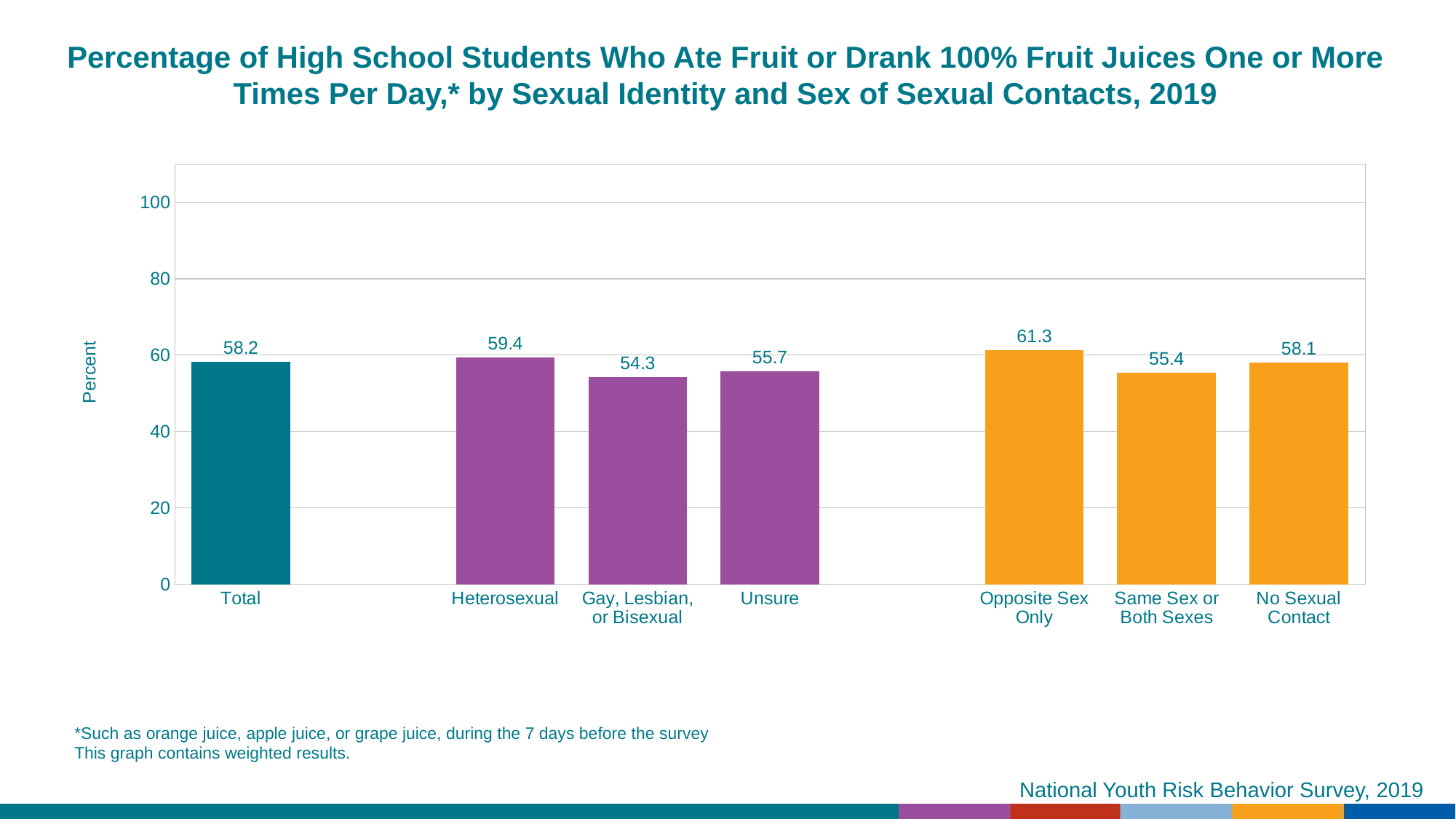
What is the value for Gay, Lesbian, or Bisexual? 54.3 What is the value for Opposite Sex Only? 61.3 What is the label of the y axis? Percent What kind of chart is shown? bar chart Which category has the highest value? Opposite Sex Only Which category has the lowest value? Gay, Lesbian, or Bisexual How many categories are shown on the x axis? 7 Which is larger, the value for Unsure or the value for Same Sex or Both Sexes? Unsure Is the value for No Sexual Contact greater or less than 60? less What is the difference between the values for Heterosexual and Gay, Lesbian, or Bisexual? 5.1 What is the value for Heterosexual? 59.4 What is the value for Total? 58.2